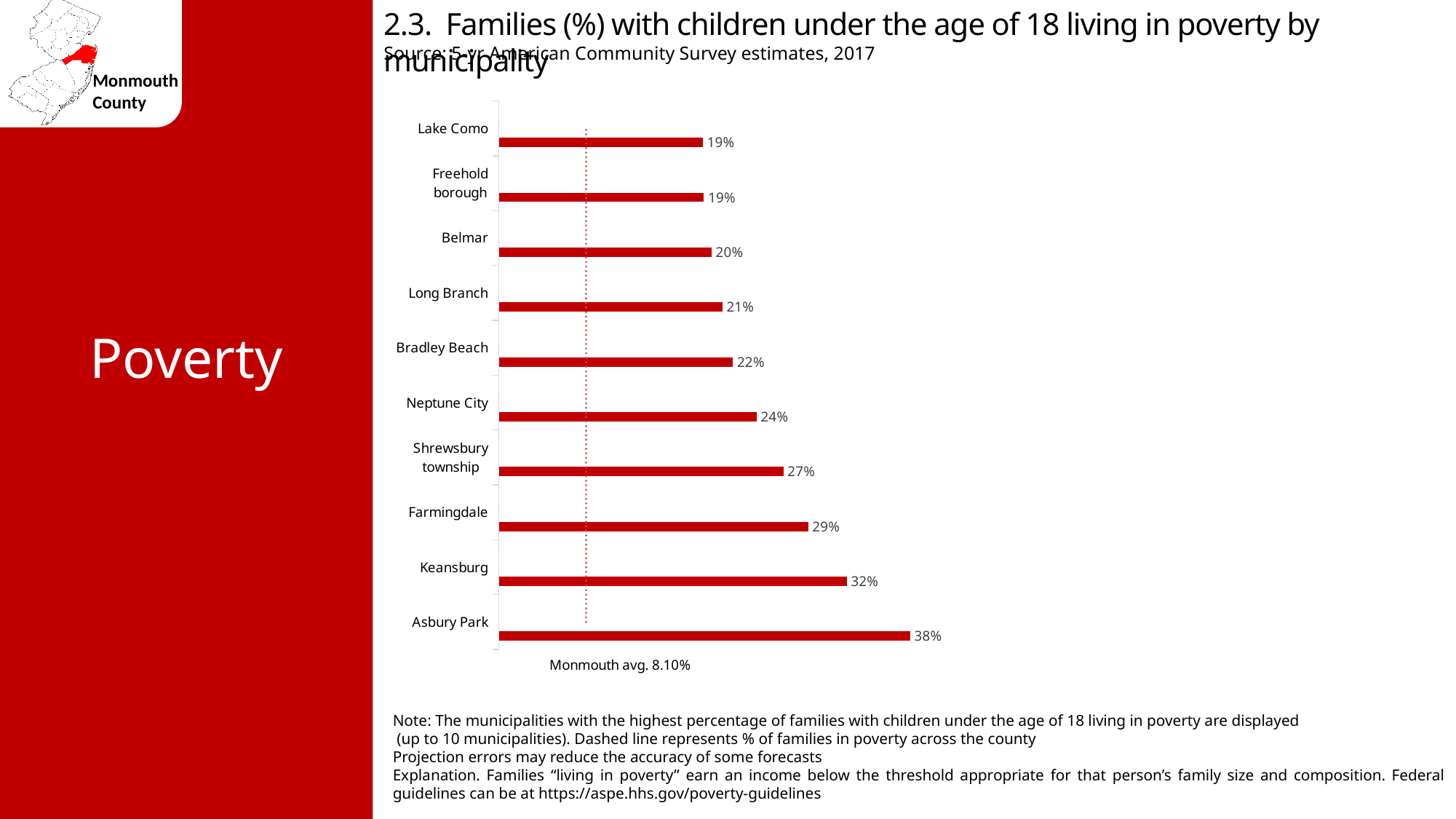
Which municipality has the highest value? Asbury Park What is the value for Neptune City? 24% What is the value for Keansburg? 32% Which is larger, the value for Farmingdale or the value for Neptune City? Farmingdale What kind of chart is shown on the slide? Bar chart How many municipalities are shown in the chart? 10 What value does the dashed line labelled Monmouth avg. represent? 8.10% What is the value for Asbury Park? 38% What is the difference between the values for Asbury Park and Keansburg? 6% What is the difference between the values for Farmingdale and Long Branch? 8% What is the value for Belmar? 20% Which is larger, the value for Shrewsbury township or the value for Bradley Beach? Shrewsbury township